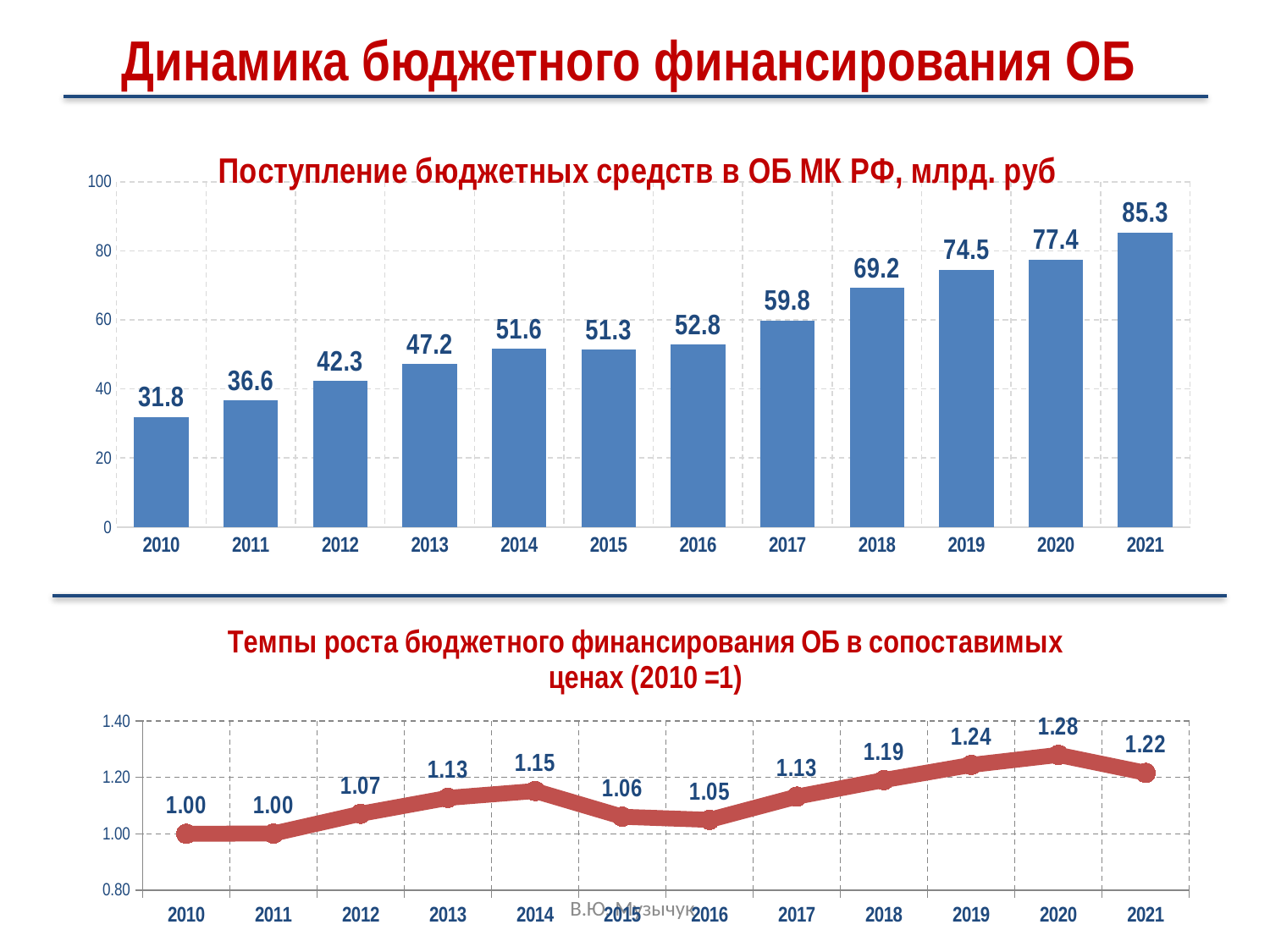
In the bottom chart (Темпы роста бюджетного финансирования ОБ в сопоставимых ценах), which year has the highest value? 2020 In the top chart (Поступление бюджетных средств в ОБ МК РФ, млрд. руб), which year has the lowest value? 2010 What kind of chart is the bottom chart on the slide? line chart In the top chart (Поступление бюджетных средств в ОБ МК РФ, млрд. руб), which is larger, the value for 2014 or the value for 2015? 2014 In the top chart (Поступление бюджетных средств в ОБ МК РФ, млрд. руб), what is the difference between the values for 2021 and 2010? 53.5 In the top chart (Поступление бюджетных средств в ОБ МК РФ, млрд. руб), what is the value for 2017? 59.8 In the top chart (Поступление бюджетных средств в ОБ МК РФ, млрд. руб), which year has the highest value? 2021 What kind of chart is the top chart on the slide? bar chart In the bottom chart (Темпы роста бюджетного финансирования ОБ в сопоставимых ценах), what is the value for 2020? 1.28 In the top chart (Поступление бюджетных средств в ОБ МК РФ, млрд. руб), do the values generally rise or fall from 2010 to 2021? rise In the bottom chart (Темпы роста бюджетного финансирования ОБ в сопоставимых ценах), what is the difference between the values for 2014 and 2016? 0.10 In the top chart (Поступление бюджетных средств в ОБ МК РФ, млрд. руб), how many years are shown on the x axis? 12